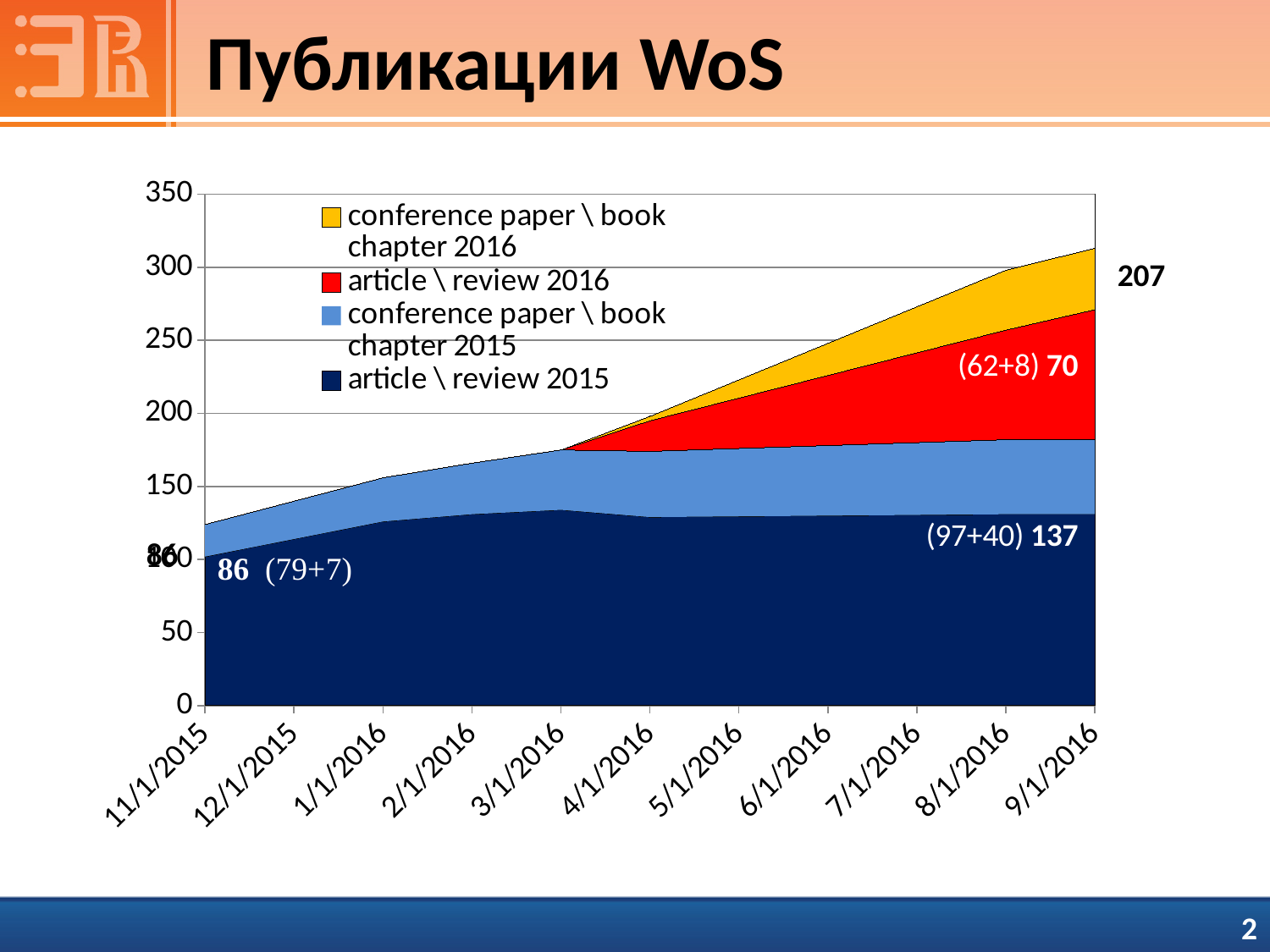
How many series does the legend list? 4 How many dates are shown on the x axis? 11 Which series is shown in yellow? conference paper \ book chapter 2016 Is the total height of the stacked area at 11/1/2015 greater or less than 150? less At 9/1/2016, which layer is thicker: article \ review 2016 or conference paper \ book chapter 2016? article \ review 2016 At which date is the total height of the stacked area highest? 9/1/2016 Which series forms the bottom layer of the stacked area? article \ review 2015 What kind of chart is shown on the slide? area chart Does the total height of the stacked area rise or fall from 11/1/2015 to 9/1/2016? rises Is the total height of the stacked area at 9/1/2016 greater or less than 250? greater What bold number is printed next to the label (97+40) on the chart? 137 At which date is the total height of the stacked area lowest? 11/1/2015